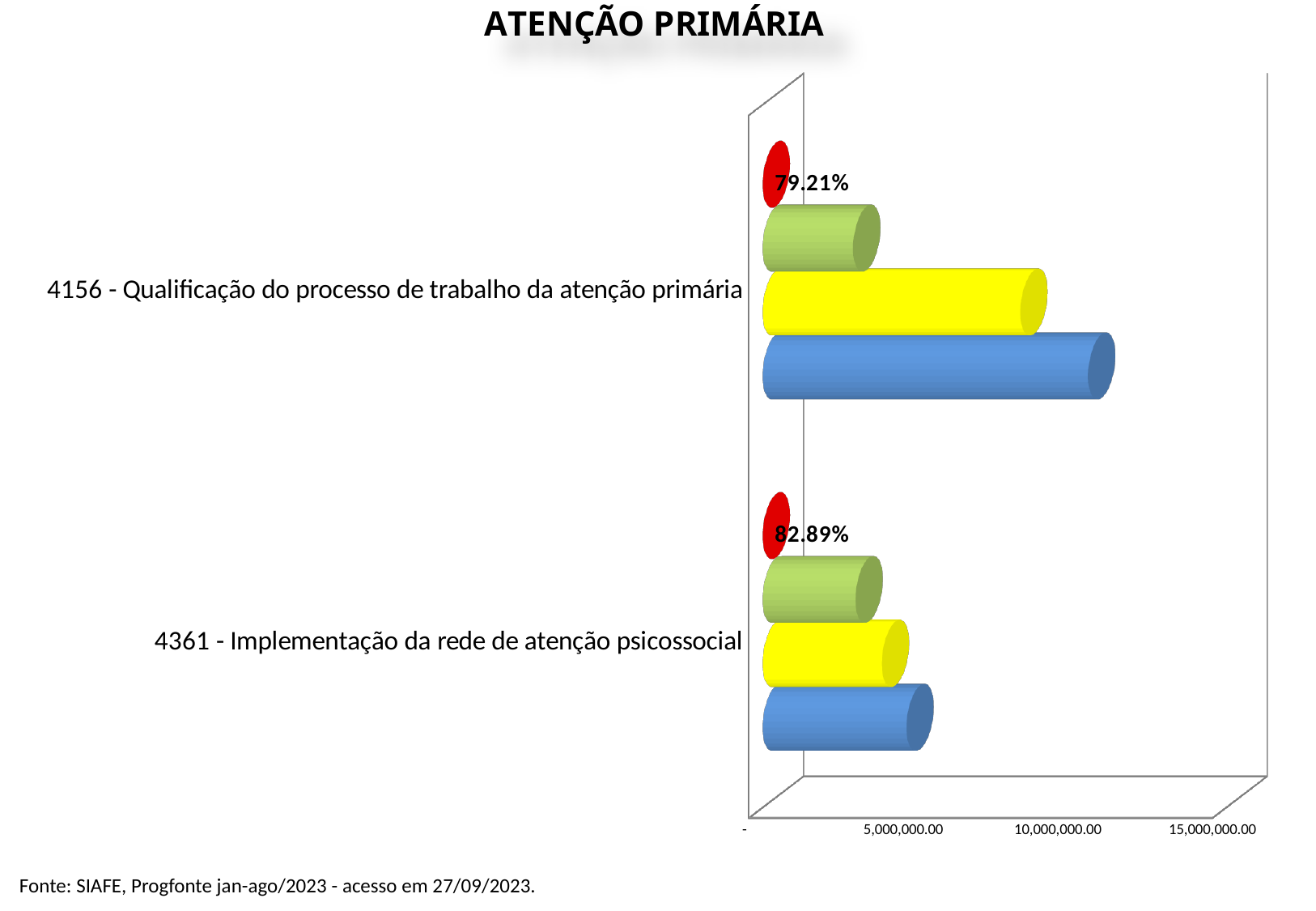
Is the blue bar for '4361 - Implementação da rede de atenção psicossocial' greater or less than 10,000,000.00? less What is the source cited below the chart? SIAFE, Progfonte jan-ago/2023 - acesso em 27/09/2023 What is the title of the chart? ATENÇÃO PRIMÁRIA Which category has the higher percentage label, 4156 or 4361? 4361 - Implementação da rede de atenção psicossocial Is the green bar for '4156 - Qualificação do processo de trabalho da atenção primária' greater or less than 5,000,000.00? less Is the blue bar for '4156 - Qualificação do processo de trabalho da atenção primária' greater or less than 10,000,000.00? greater What kind of chart is shown on the slide? bar chart What percentage is labelled for '4361 - Implementação da rede de atenção psicossocial'? 82.89% Which category has the longer blue bar? 4156 - Qualificação do processo de trabalho da atenção primária How many categories (programs) are shown on the chart? 2 What percentage is labelled for '4156 - Qualificação do processo de trabalho da atenção primária'? 79.21%